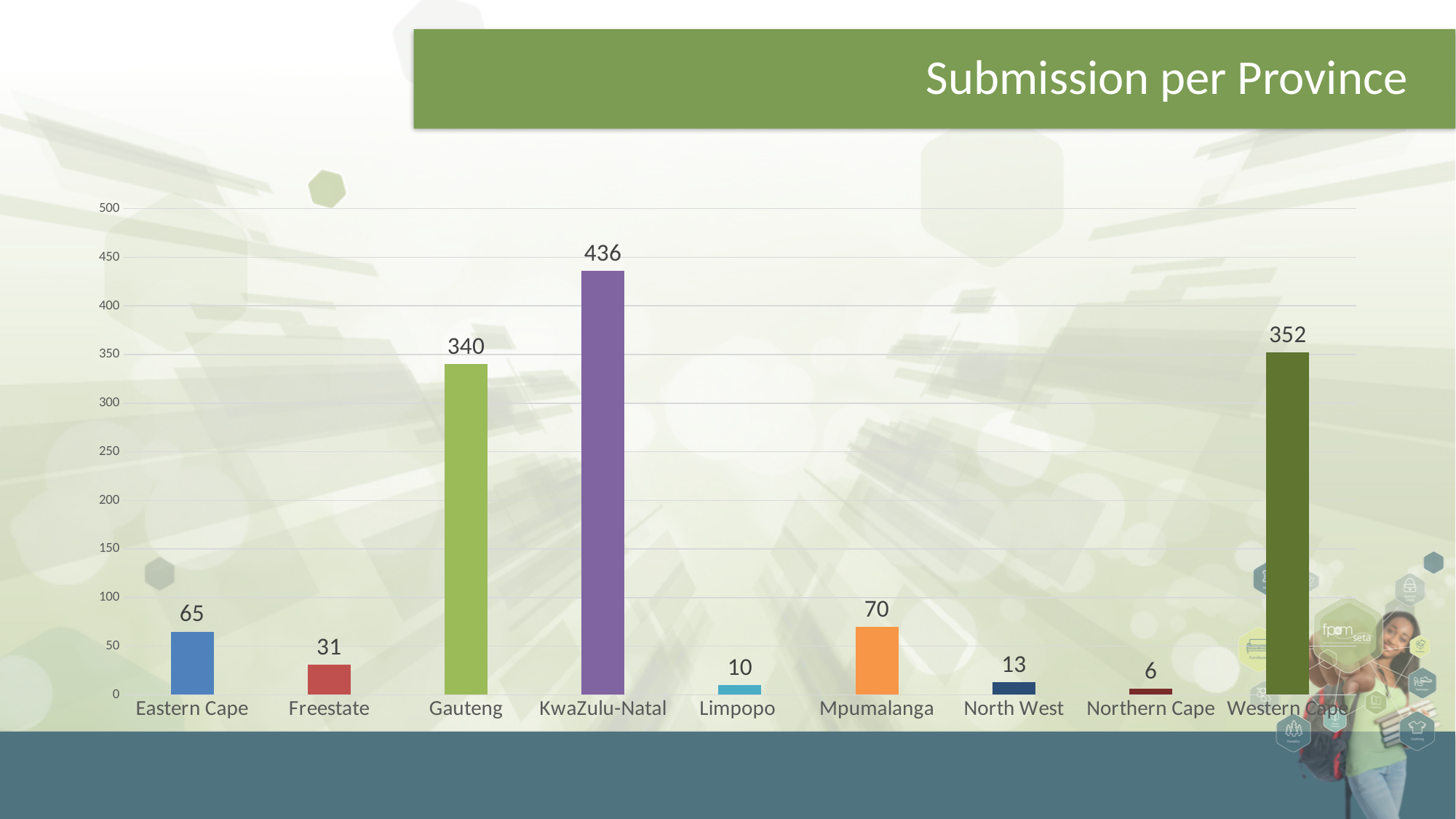
What is the difference between the values for Eastern Cape and Freestate? 34 What is the value for KwaZulu-Natal? 436 What is the value for Mpumalanga? 70 What kind of chart is shown on the slide? bar chart How many provinces are shown on the chart? 9 What is the difference between the values for KwaZulu-Natal and Western Cape? 84 Which is larger, the value for Gauteng or the value for Western Cape? Western Cape What is the title of the chart? Submission per Province Which province has the lowest value? Northern Cape Is the value for Gauteng greater or less than 300? greater Which province has the highest value? KwaZulu-Natal What is the value for Northern Cape? 6